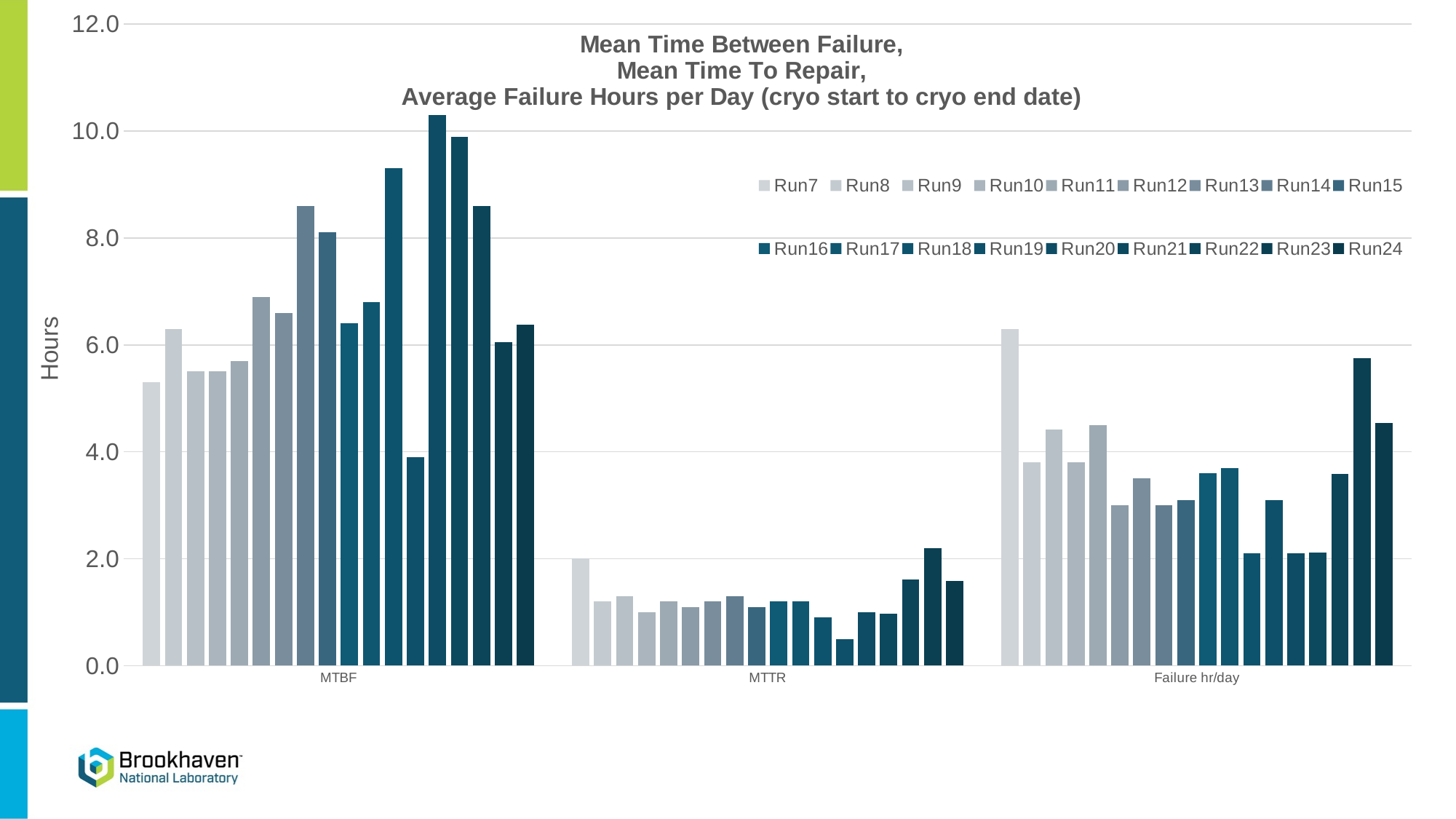
Is the Run7 value for Failure hr/day greater or less than 6.0? greater How many series does the legend list? 18 Is the tallest bar in the MTBF category greater or less than 10.0? greater Is the Run7 value for MTTR greater or less than 1.0? greater What kind of chart is shown on the slide? bar chart Which category has the lowest bars overall? MTTR What is the label of the y axis? Hours Which category contains the tallest bar in the chart? MTBF What is the highest value shown on the y axis? 12.0 How many categories are shown on the x axis? 3